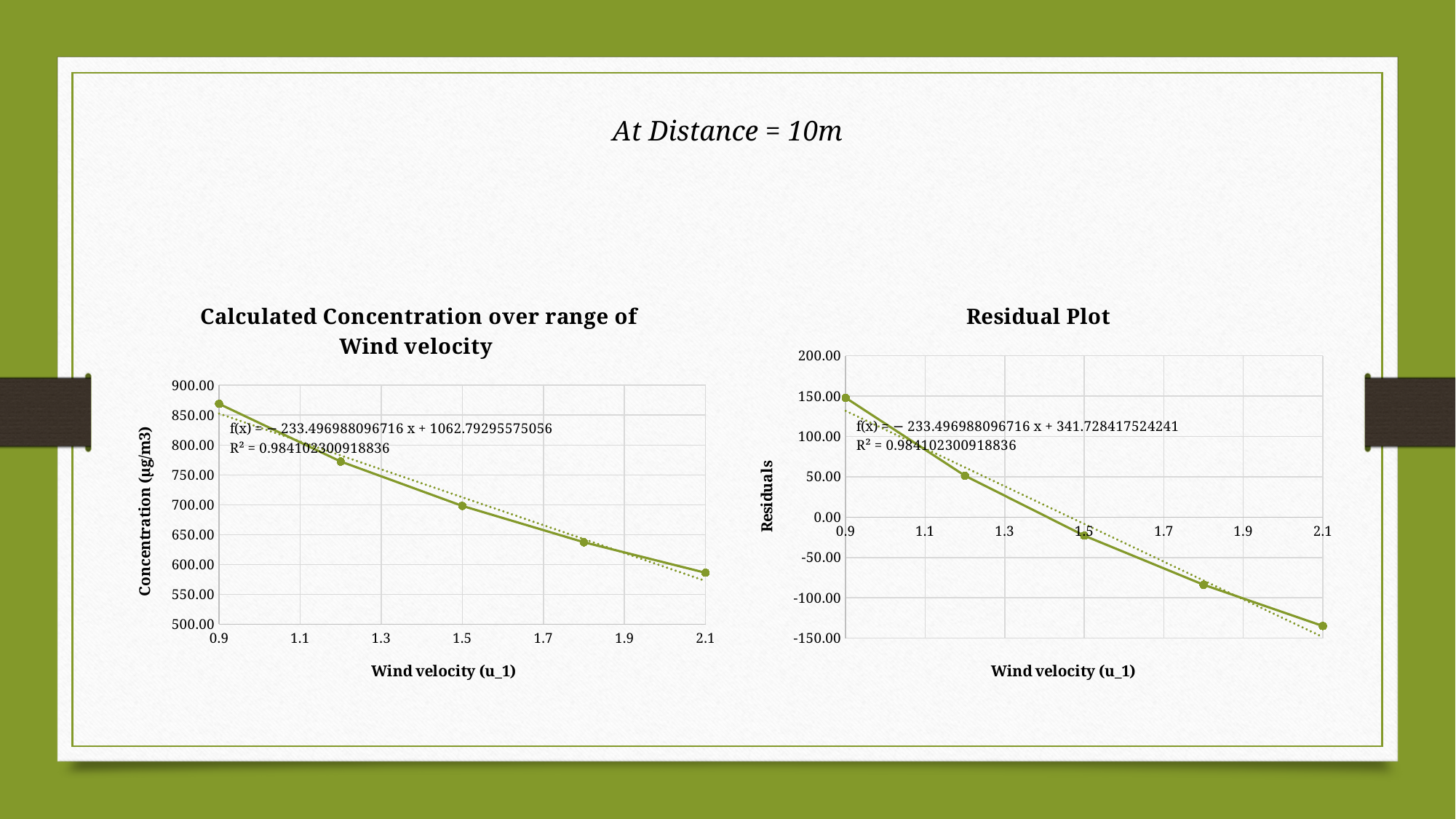
On the 'Calculated Concentration over range of Wind velocity' chart, is the concentration at wind velocity 2.1 greater or less than 600.00? less On the 'Calculated Concentration over range of Wind velocity' chart, do the values rise or fall as wind velocity increases? fall On the 'Calculated Concentration over range of Wind velocity' chart, at which wind velocity is the concentration lowest? 2.1 How many data points are plotted on the 'Residual Plot' chart? 5 What kind of chart is the 'Calculated Concentration over range of Wind velocity' chart? line chart On the 'Residual Plot' chart, which is larger: the residual at wind velocity 1.2 or at wind velocity 1.8? 1.2 On the 'Calculated Concentration over range of Wind velocity' chart, at which wind velocity is the concentration highest? 0.9 On the 'Residual Plot' chart, do the residuals rise or fall as wind velocity increases? fall On the 'Calculated Concentration over range of Wind velocity' chart, is the concentration at wind velocity 0.9 greater or less than 850.00? greater On the 'Residual Plot' chart, is the residual at wind velocity 2.1 greater or less than -100.00? less What R² value is shown on the 'Residual Plot' chart? 0.984102300918836